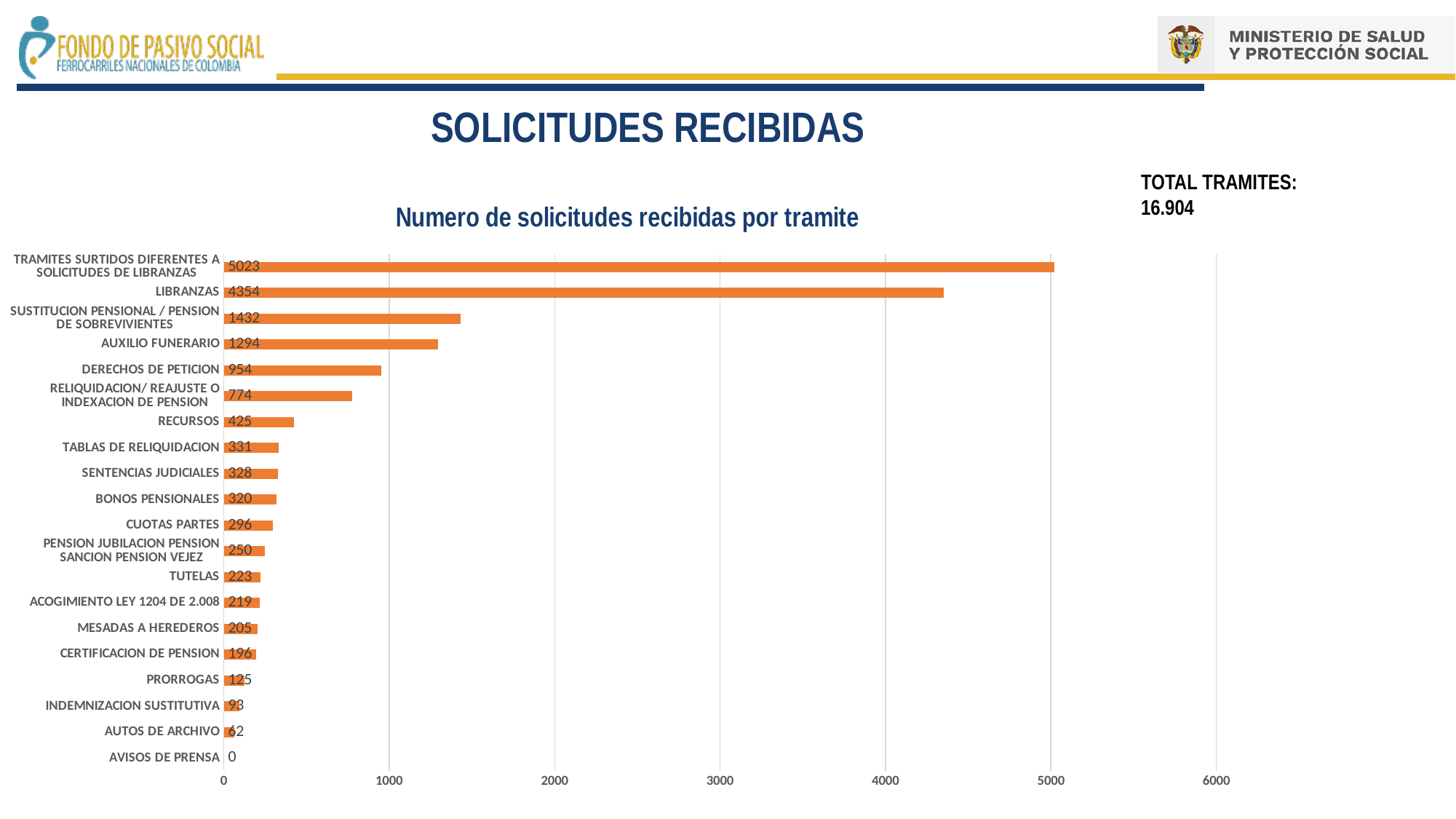
What is the value for TUTELAS? 223 How many categories (tramites) are plotted in the chart? 20 What is the value for DERECHOS DE PETICION? 954 Which is larger, the value for RECURSOS or the value for CUOTAS PARTES? RECURSOS What type of chart is shown on the slide? Bar chart What is the value for LIBRANZAS? 4354 What is the difference between the values for TRAMITES SURTIDOS DIFERENTES A SOLICITUDES DE LIBRANZAS and LIBRANZAS? 669 Is the value for SUSTITUCION PENSIONAL / PENSION DE SOBREVIVIENTES greater or less than 1000? greater What is the value for AUXILIO FUNERARIO? 1294 Which category has the highest value? TRAMITES SURTIDOS DIFERENTES A SOLICITUDES DE LIBRANZAS Which category has the lowest value? AVISOS DE PRENSA What is the title of the chart? Numero de solicitudes recibidas por tramite